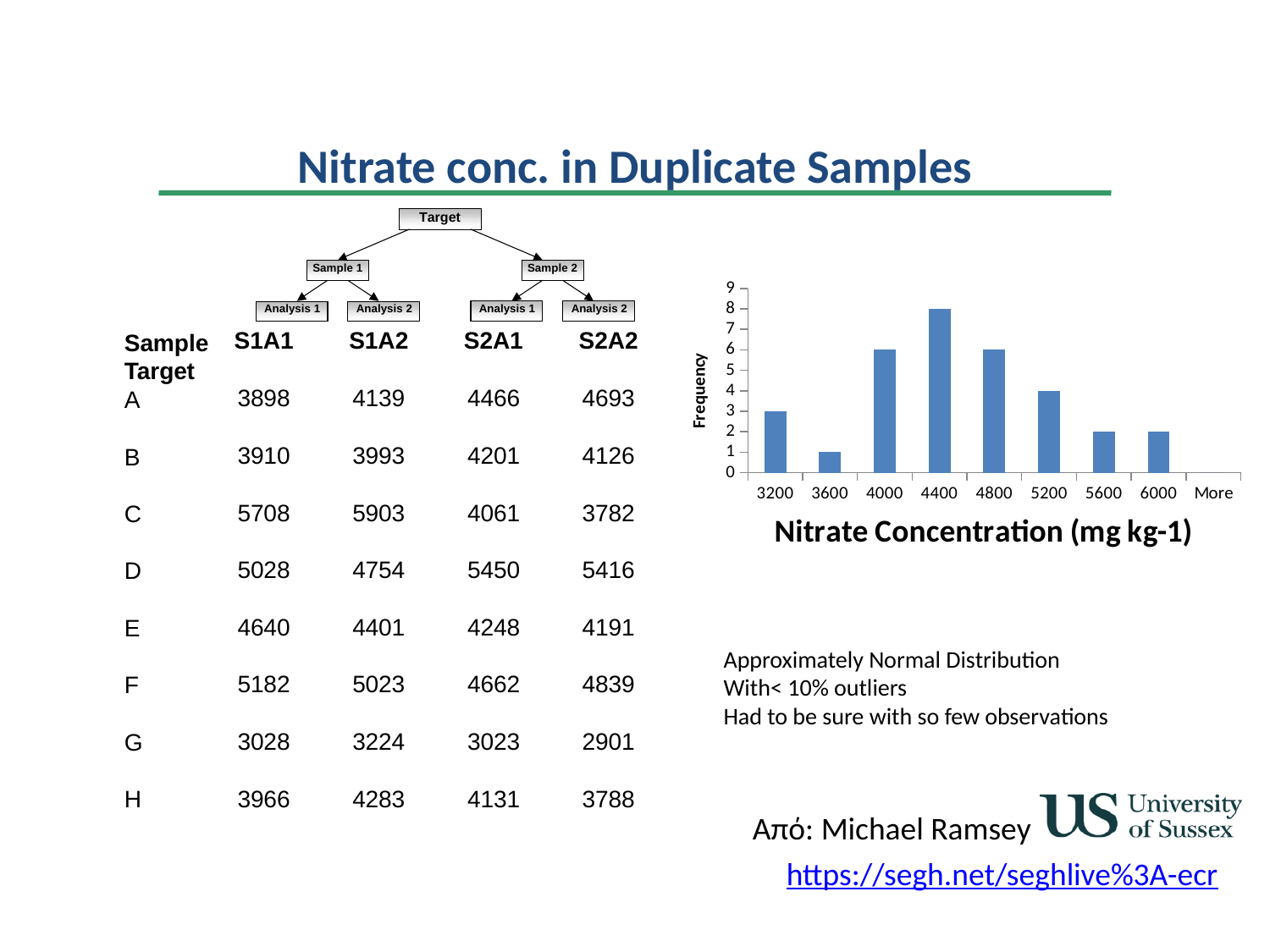
Which bin has the highest frequency? 4400 What is the x-axis title of the chart? Nitrate Concentration (mg kg-1) What is the difference in frequency between the 4400 bin and the 3200 bin? 5 Which bin has the larger frequency, 4000 or 5200? 4000 What kind of chart is shown on the slide? bar chart What is the frequency for the 3200 bin? 3 Is the frequency for the 4800 bin greater or less than 5? greater What is the frequency for the 5200 bin? 4 What is the frequency for the 4400 bin? 8 What is the frequency for the 3600 bin? 1 How many bins are labelled on the x axis? 9 Among the bins with a visible bar, which has the lowest frequency? 3600